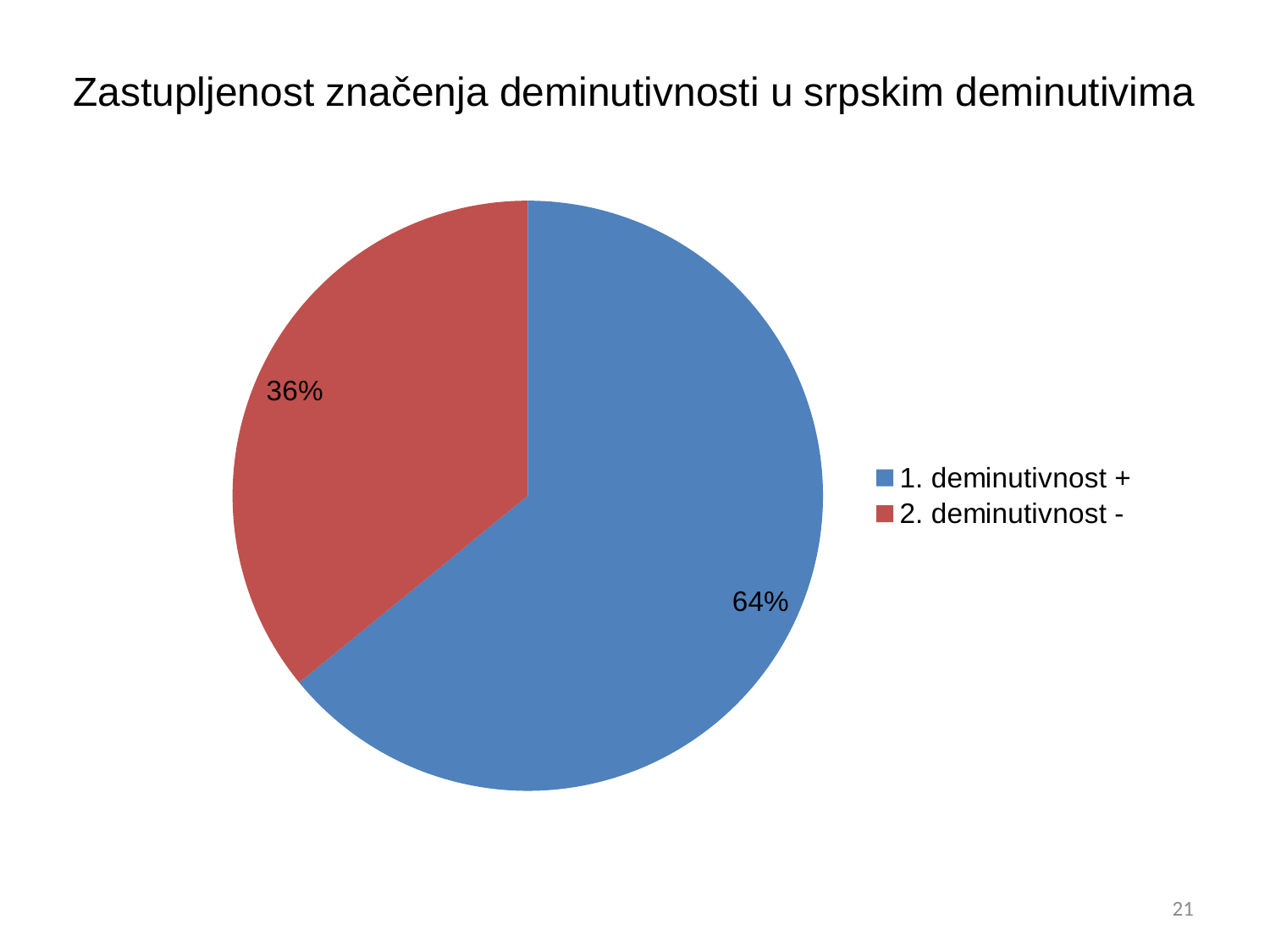
Which slice is the largest? 1. deminutivnost + Which is larger, the "1. deminutivnost +" slice or the "2. deminutivnost -" slice? 1. deminutivnost + What kind of chart is shown on the slide? pie chart What share of the pie does "1. deminutivnost +" have? 64% What colour is the "2. deminutivnost -" slice? red What share of the pie does "2. deminutivnost -" have? 36% What is the title of the slide? Zastupljenost značenja deminutivnosti u srpskim deminutivima Which slice is the smallest? 2. deminutivnost - How many entries does the legend list? 2 How many slices does the pie chart have? 2 What is the difference in percentage points between the "1. deminutivnost +" and "2. deminutivnost -" slices? 28